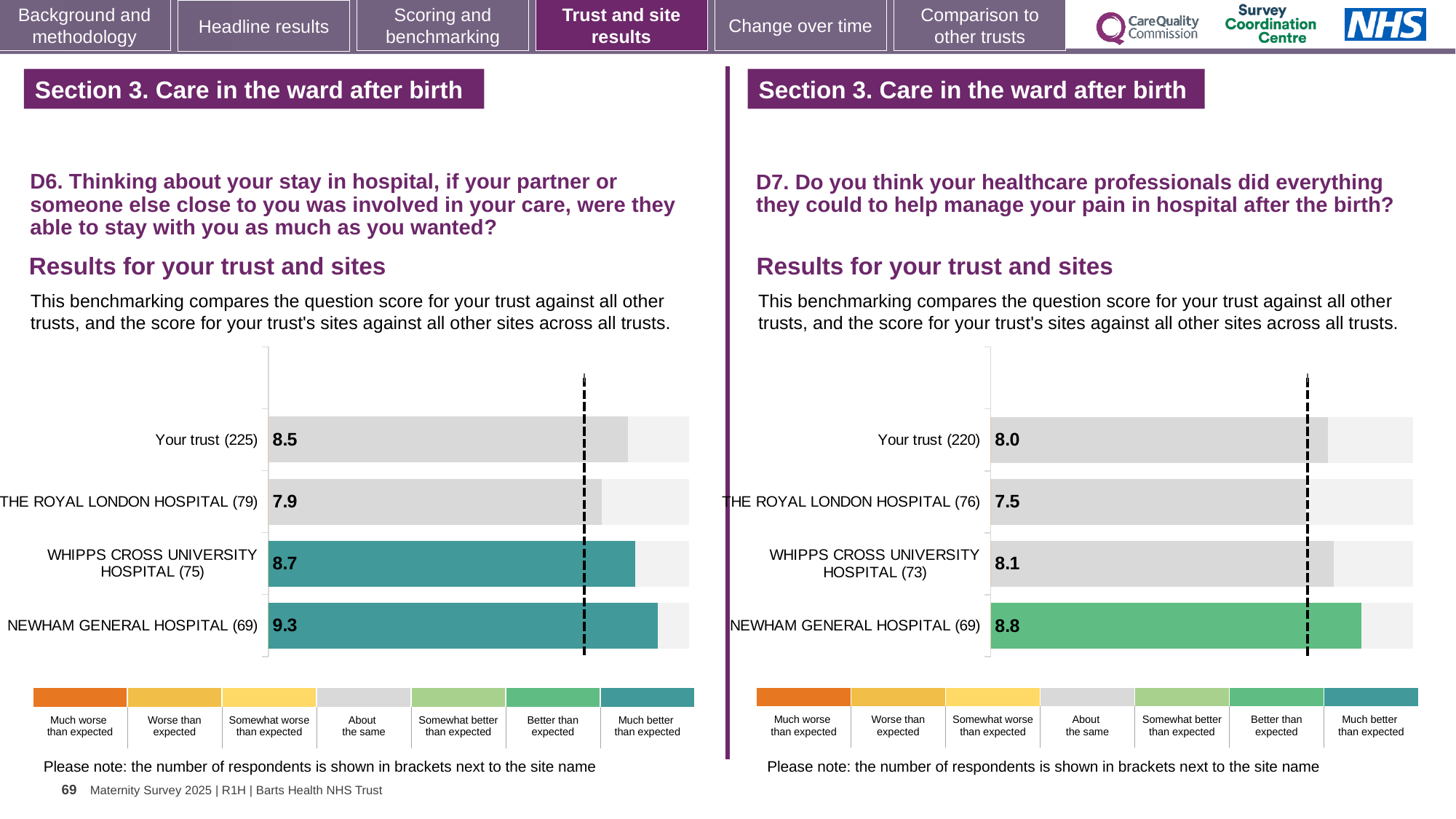
In the D6 chart on the left, which site or trust has the lowest score? THE ROYAL LONDON HOSPITAL In the D6 chart on the left, what is the score for NEWHAM GENERAL HOSPITAL? 9.3 In the D7 chart on the right, which site or trust has the highest score? NEWHAM GENERAL HOSPITAL In the D7 chart on the right, which benchmark category does the colour of the NEWHAM GENERAL HOSPITAL bar correspond to? Better than expected In the D7 chart on the right, which has a higher score, Your trust or NEWHAM GENERAL HOSPITAL? NEWHAM GENERAL HOSPITAL What kind of chart is used in the D7 chart on the right? Bar chart How many bars are plotted in the D6 chart on the left? 4 In the D7 chart on the right, what is the score for THE ROYAL LONDON HOSPITAL? 7.5 In the D7 chart on the right, what is the difference between the scores for WHIPPS CROSS UNIVERSITY HOSPITAL and Your trust? 0.1 In the D6 chart on the left, what is the score for Your trust? 8.5 In the D7 chart on the right, how many respondents are shown in brackets for Your trust? 220 In the D6 chart on the left, what is the difference between the scores for NEWHAM GENERAL HOSPITAL and THE ROYAL LONDON HOSPITAL? 1.4